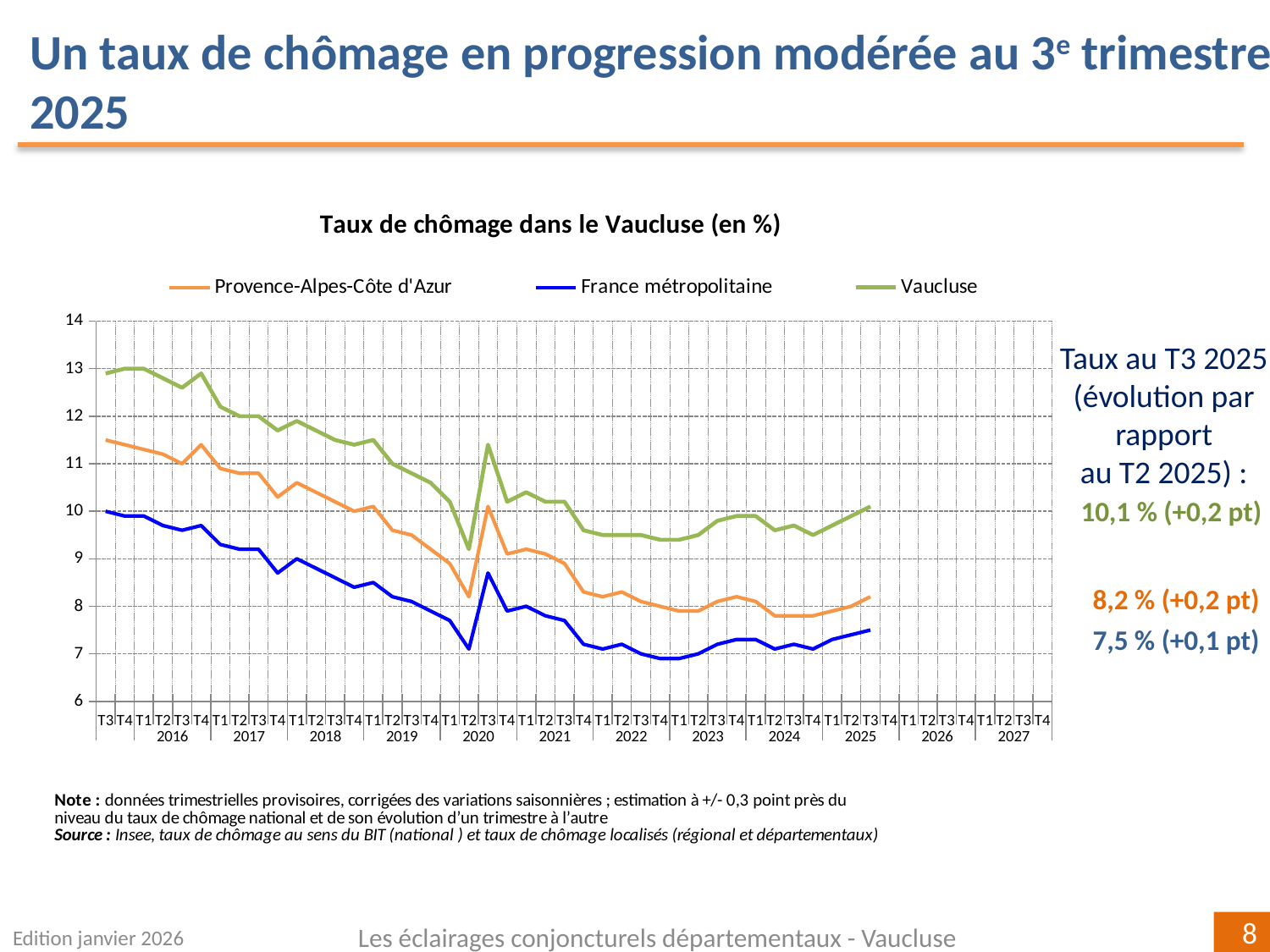
How many series does the legend list? 3 What is the title of the chart? Taux de chômage dans le Vaucluse (en %) Overall, does the Vaucluse unemployment rate rise or fall between T3 2015 and T3 2025? fall Is the France métropolitaine rate at T2 2020 greater or less than 8? less Is the Vaucluse rate at T3 2015 greater or less than 12? greater By how many points did the Vaucluse rate change between T2 2025 and T3 2025? +0,2 pt At T3 2025, which is higher: the rate for Vaucluse or for Provence-Alpes-Côte d'Azur? Vaucluse What is the unemployment rate for Vaucluse at T3 2025? 10,1 % What is the unemployment rate for Provence-Alpes-Côte d'Azur at T3 2025? 8,2 % What is the unemployment rate for France métropolitaine at T3 2025? 7,5 % What is the difference between the Vaucluse rate and the France métropolitaine rate at T3 2025? 2,6 points What kind of chart is shown on the slide? line chart